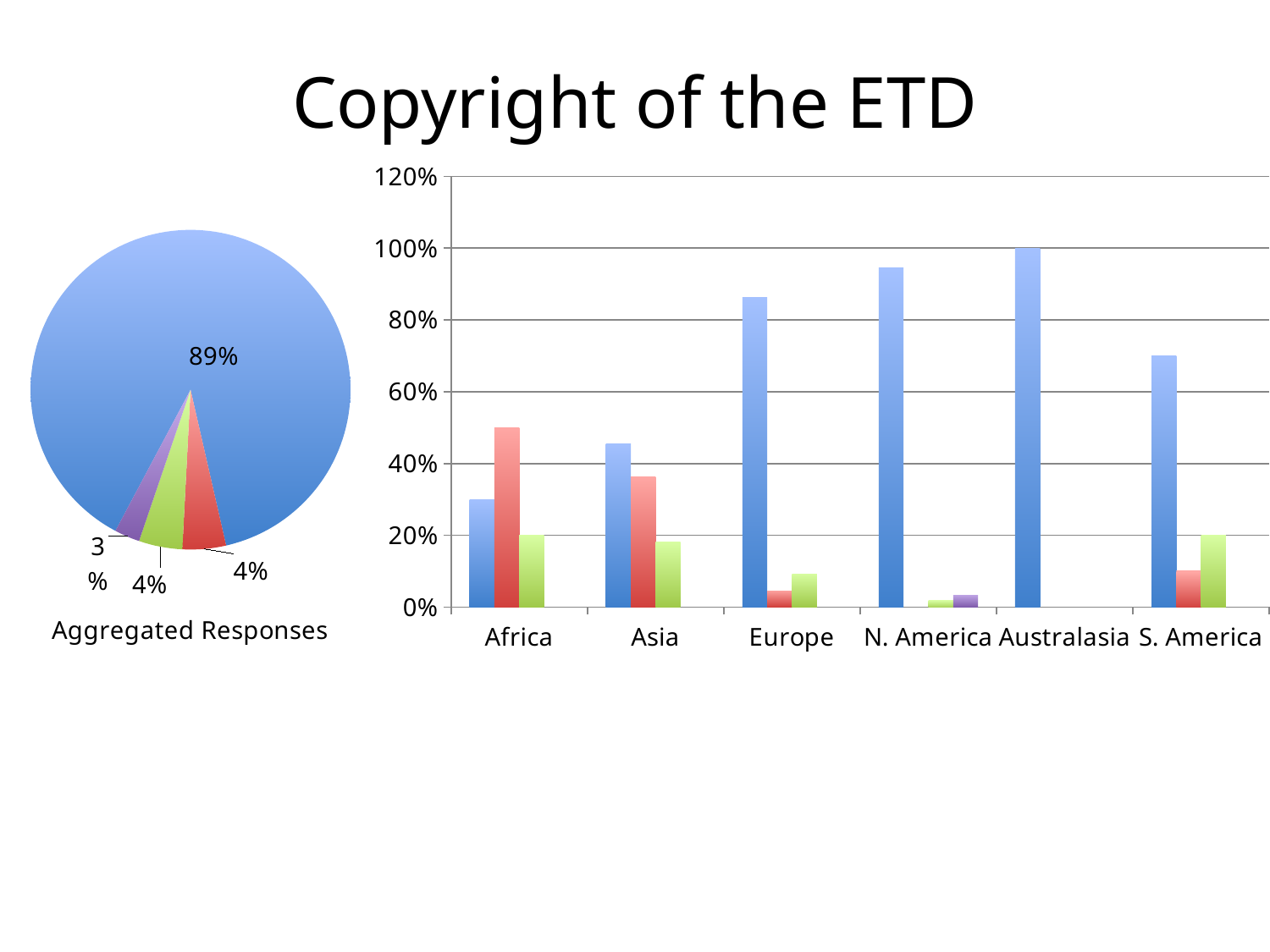
In the bar chart on the right, is the blue bar for Africa greater or less than 40%? less In the bar chart on the right, which category has the lowest blue bar? Africa What kind of chart is the chart on the left of the slide, labelled Aggregated Responses? pie chart How many slices does the Aggregated Responses pie chart have? 4 In the Aggregated Responses pie chart, what share does the smallest slice (the purple one) have? 3% In the Aggregated Responses pie chart, what share does the largest slice have? 89% In the bar chart on the right, which category has the tallest blue bar? Australasia In the bar chart on the right, which is larger for Africa: the blue bar or the red bar? the red bar How many categories are shown on the x axis of the bar chart on the right? 6 In the bar chart on the right, what is the value of the blue bar for Australasia? 100% What kind of chart is the chart on the right of the slide? bar chart In the bar chart on the right, is the blue bar for Europe greater or less than 80%? greater